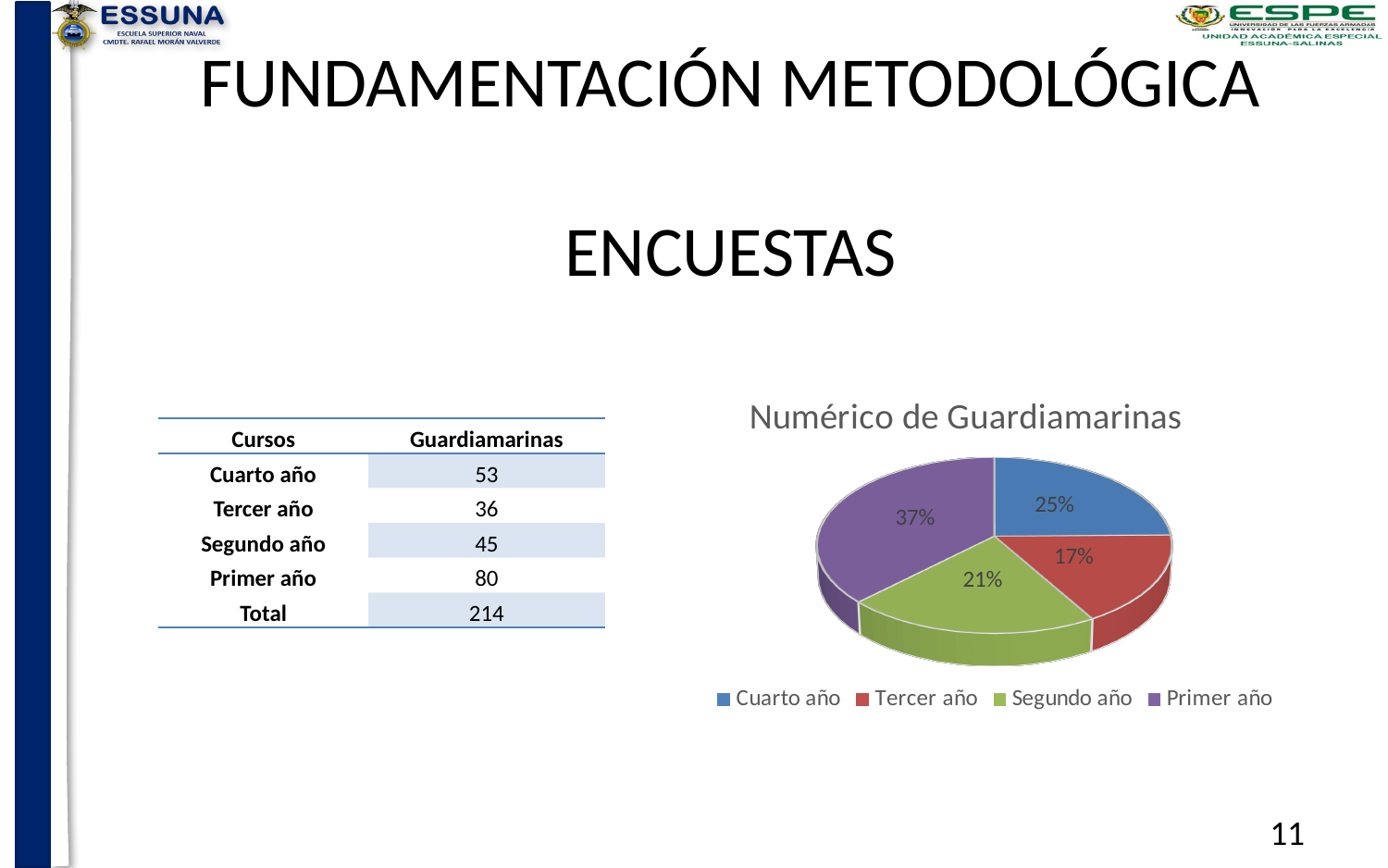
How many entries does the legend of the pie chart list? 4 What is the difference in percentage points between the Primer año slice and the Tercer año slice? 20% What is the title of the chart? Numérico de Guardiamarinas What percentage share does the Segundo año slice have in the pie chart? 21% What percentage share does the Tercer año slice have in the pie chart? 17% What kind of chart is shown on the slide? pie chart Which category has the largest slice in the pie chart? Primer año How many slices does the pie chart have? 4 What percentage share does the Cuarto año slice have in the pie chart? 25% Which slice is larger in the pie chart, Segundo año or Cuarto año? Cuarto año Which category has the smallest slice in the pie chart? Tercer año